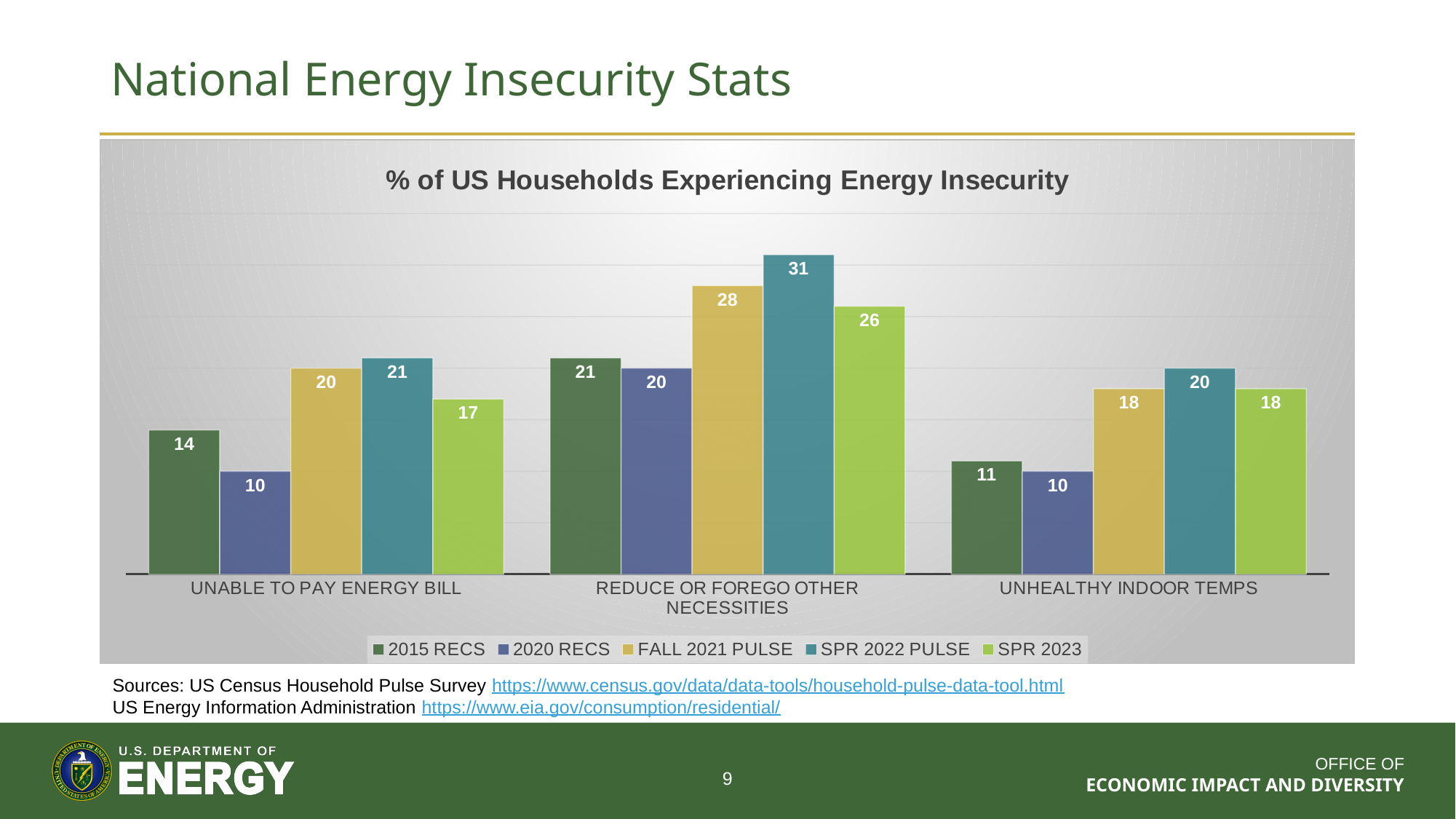
What is the value for SPR 2022 PULSE in the REDUCE OR FOREGO OTHER NECESSITIES category? 31 What kind of chart is shown on the slide? bar chart What is the difference between the SPR 2022 PULSE and 2015 RECS values in the UNABLE TO PAY ENERGY BILL category? 7 How many series does the legend list? 5 What is the title of the chart? % of US Households Experiencing Energy Insecurity Which series has the highest value in the REDUCE OR FOREGO OTHER NECESSITIES category? SPR 2022 PULSE Which category has the highest 2015 RECS value? REDUCE OR FOREGO OTHER NECESSITIES Which is larger: the SPR 2023 value for REDUCE OR FOREGO OTHER NECESSITIES or the SPR 2023 value for UNABLE TO PAY ENERGY BILL? REDUCE OR FOREGO OTHER NECESSITIES How many categories are shown on the x axis? 3 What is the value for 2020 RECS in the UNABLE TO PAY ENERGY BILL category? 10 Which series has the lowest value in the UNHEALTHY INDOOR TEMPS category? 2020 RECS What is the value for FALL 2021 PULSE in the UNHEALTHY INDOOR TEMPS category? 18